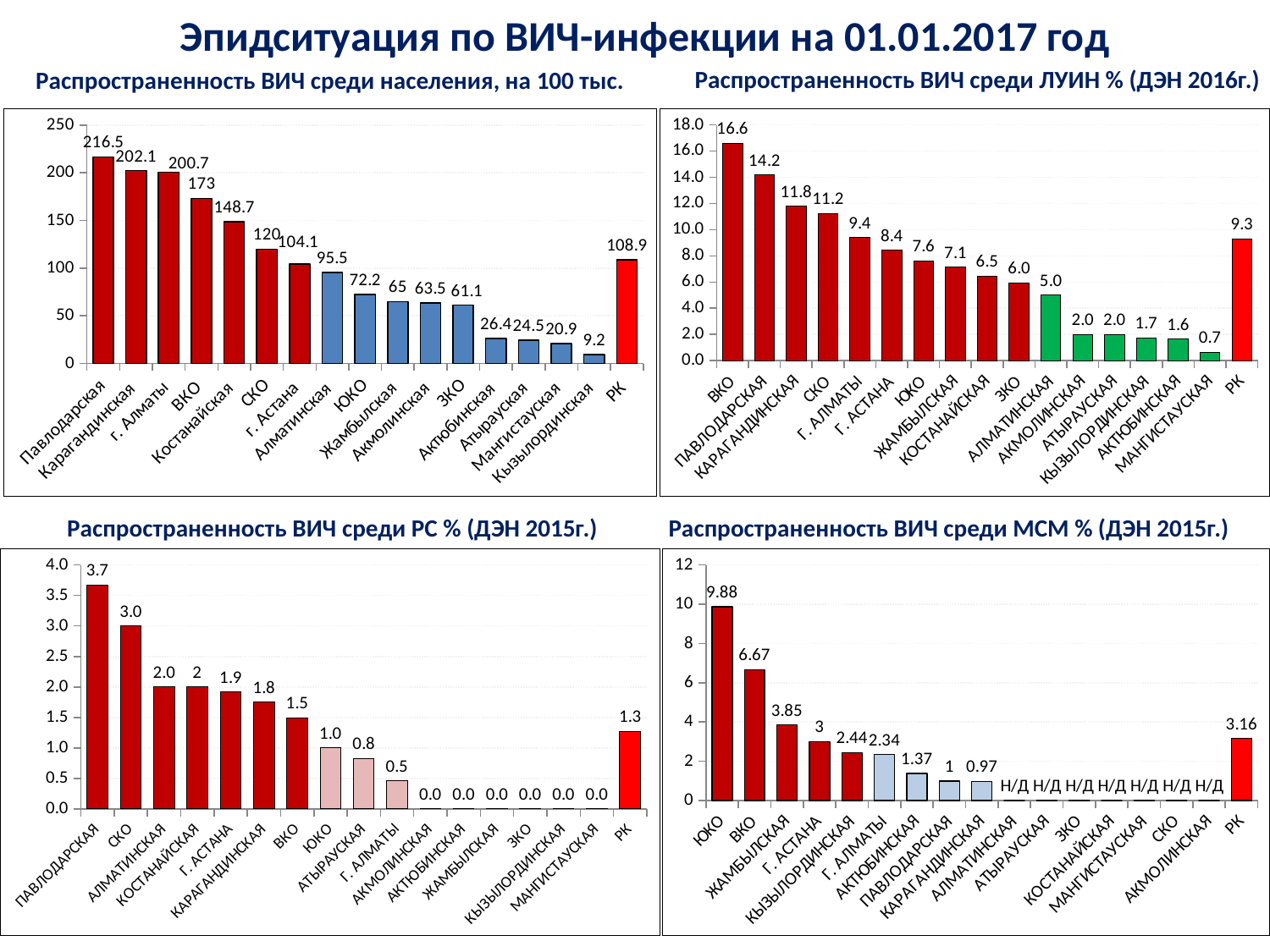
In the chart 'Распространенность ВИЧ среди ЛУИН % (ДЭН 2016г.)', which is larger, СКО or г. Алматы? СКО In the chart 'Распространенность ВИЧ среди населения, на 100 тыс.', what is the value for РК? 108.9 What type of chart is 'Распространенность ВИЧ среди МСМ % (ДЭН 2015г.)'? Bar chart In the chart 'Распространенность ВИЧ среди населения, на 100 тыс.', which region has the lowest value? Кызылординская In the chart 'Распространенность ВИЧ среди ЛУИН % (ДЭН 2016г.)', which region has the highest value? ВКО In the chart 'Распространенность ВИЧ среди МСМ % (ДЭН 2015г.)', what is the value for ЮКО? 9.88 In the chart 'Распространенность ВИЧ среди ЛУИН % (ДЭН 2016г.)', what is the value for Алматинская? 5.0 In the chart 'Распространенность ВИЧ среди МСМ % (ДЭН 2015г.)', what is the difference between ВКО and Жамбылская? 2.82 In the chart 'Распространенность ВИЧ среди населения, на 100 тыс.', what is the difference between Карагандинская and г. Алматы? 1.4 In the chart 'Распространенность ВИЧ среди РС % (ДЭН 2015г.)', what is the value for СКО? 3.0 In the chart 'Распространенность ВИЧ среди населения, на 100 тыс.', what is the value for Павлодарская? 216.5 In the chart 'Распространенность ВИЧ среди РС % (ДЭН 2015г.)', how many categories are shown on the x axis? 17